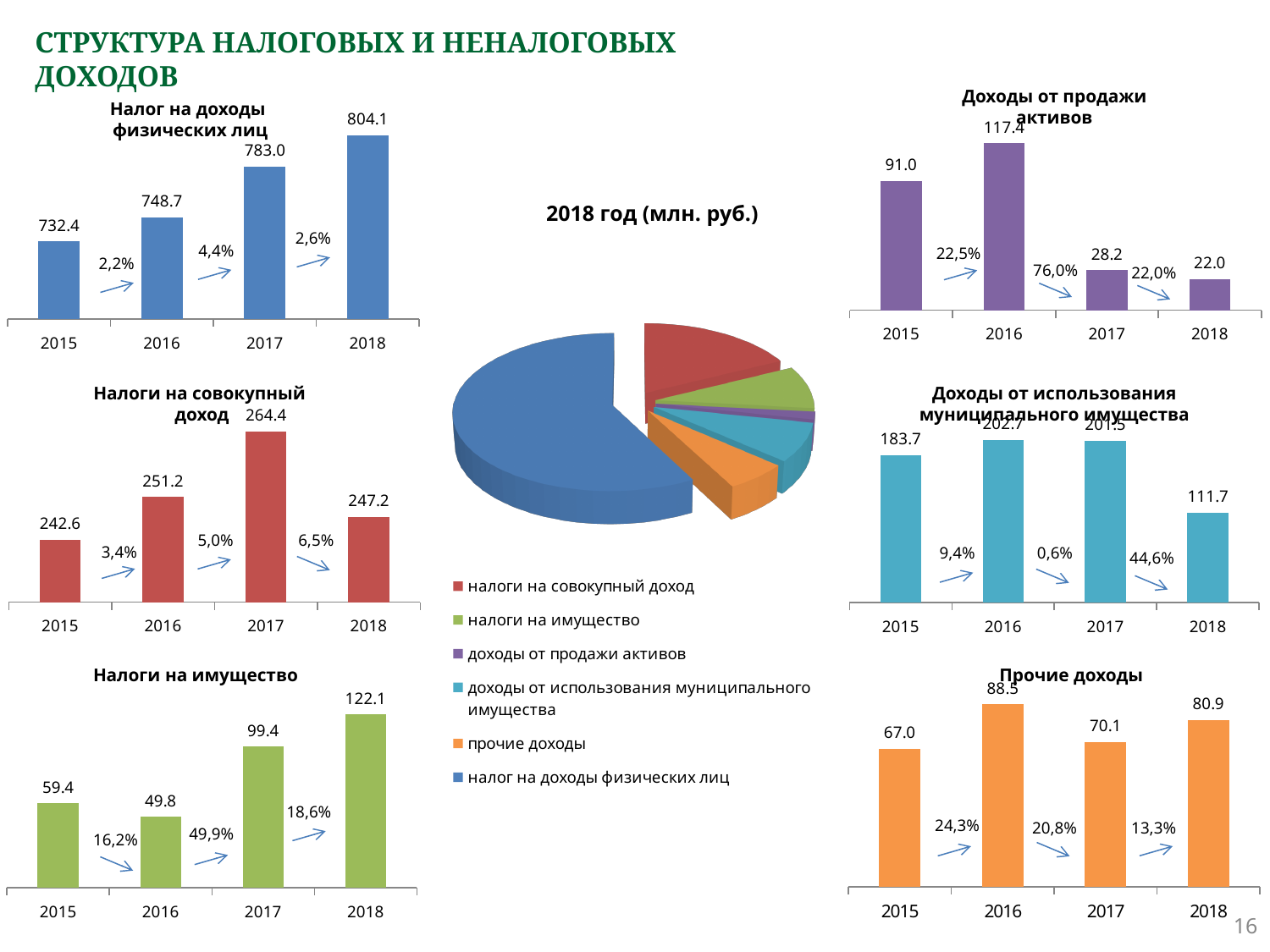
How many entries does the legend of the pie chart '2018 год (млн. руб.)' list? 6 In the chart 'Налоги на совокупный доход', which year has the highest value? 2017 In the chart 'Налог на доходы физических лиц', do the values rise or fall from 2015 to 2018? rise What kind of chart is the chart titled '2018 год (млн. руб.)'? pie chart In the chart 'Доходы от использования муниципального имущества', what is the difference between the 2015 and 2018 values? 72.0 In the chart 'Налоги на имущество', which year has the lowest value? 2016 In the chart 'Налоги на совокупный доход', what is the difference between the 2017 and 2018 values? 17.2 In the chart 'Налог на доходы физических лиц', what is the value for 2018? 804.1 In the chart 'Прочие доходы', how many years are shown on the x axis? 4 In the chart 'Доходы от продажи активов', what is the value for 2018? 22.0 In the chart 'Доходы от продажи активов', which is larger, the value for 2015 or the value for 2016? 2016 In the chart 'Налоги на имущество', what is the value for 2017? 99.4